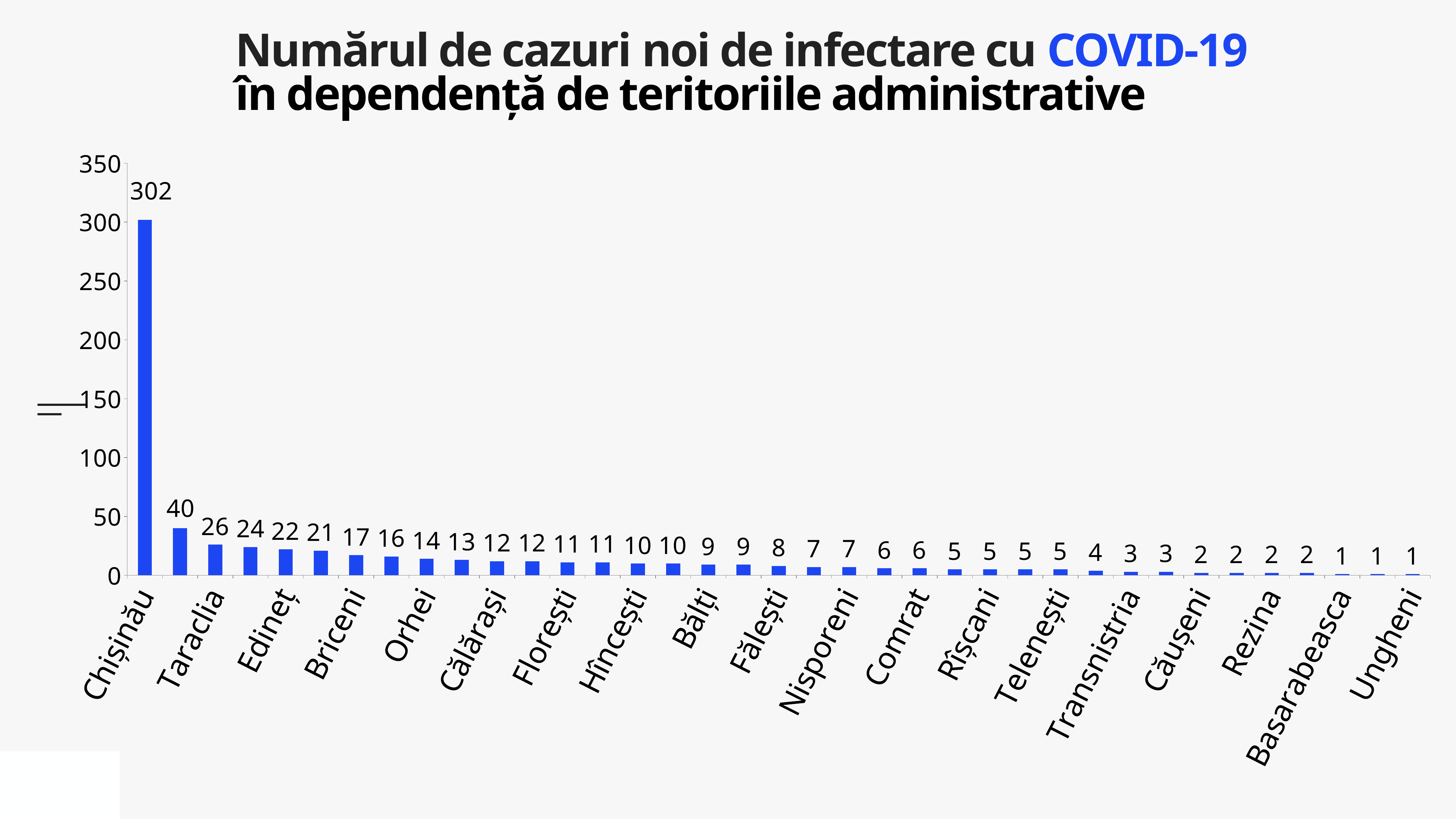
What is the difference between the number of cases in Chișinău and in Ungheni? 301 How many new COVID-19 cases are shown for Chișinău? 302 Do the values rise or fall from left to right along the x axis? fall How many bars are plotted in the chart? 37 Which administrative territory has the highest number of new COVID-19 cases? Chișinău How many new COVID-19 cases are shown for Bălți? 9 What type of chart is shown on the slide? bar chart How many new COVID-19 cases are shown for Ungheni? 1 Is the value for Chișinău greater or less than 300? greater What is the highest value shown on the vertical axis? 350 Which has more new cases, Chișinău or Basarabeasca? Chișinău How many new COVID-19 cases are shown for Comrat? 6